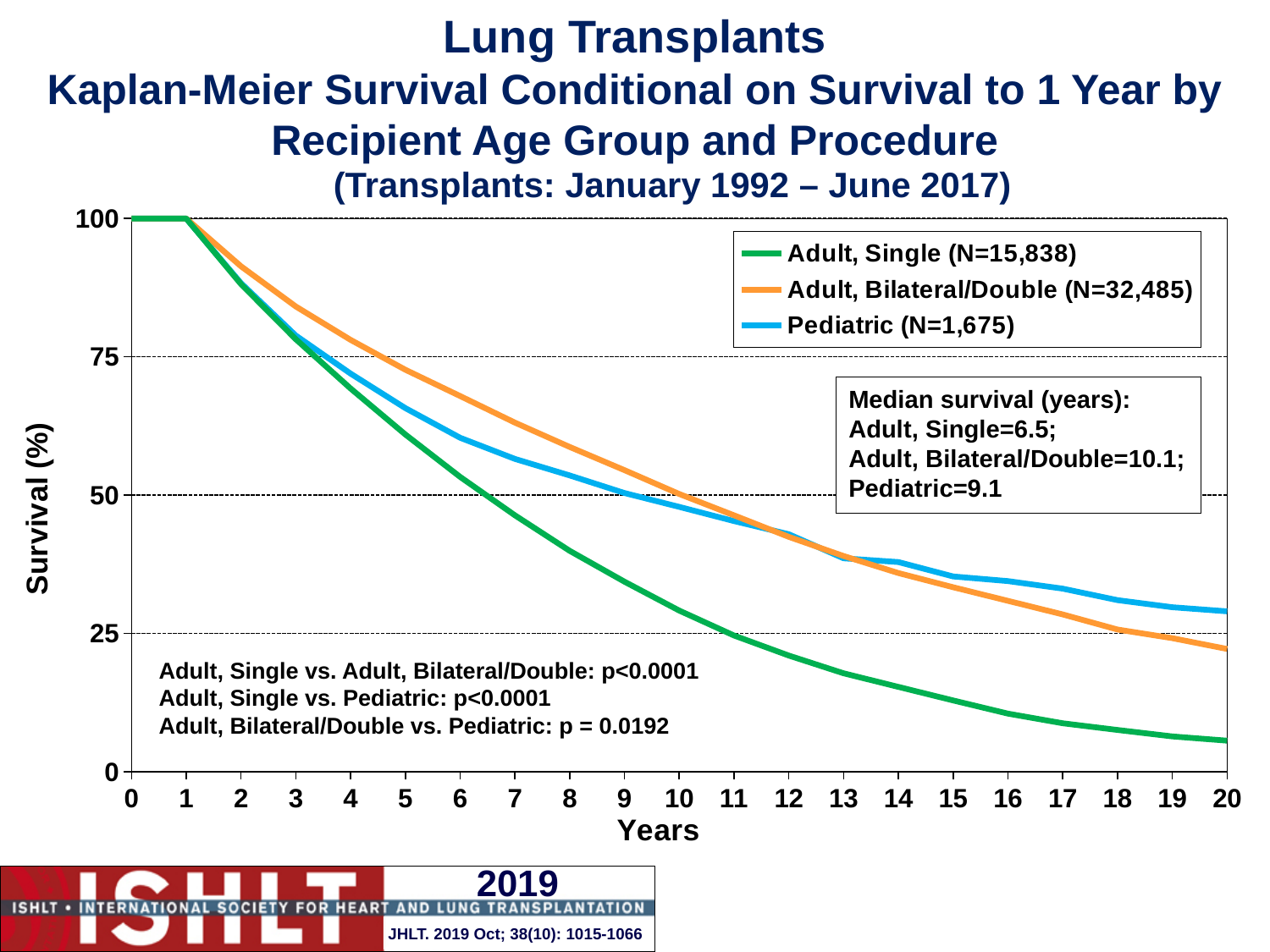
Is the survival value for Pediatric at 15 years greater or less than 25? greater Which group has the highest median survival? Adult, Bilateral/Double What is the median survival in years for the Pediatric group? 9.1 At 20 years, which curve is higher: Pediatric or Adult, Single? Pediatric How many series does the legend list? 3 What is the sample size (N) for the Pediatric group? 1,675 What is the median survival in years for the Adult, Single group? 6.5 Which group has the lowest median survival? Adult, Single What is the difference in median survival (years) between Adult, Bilateral/Double and Adult, Single? 3.6 What is the p-value for Adult, Bilateral/Double vs. Pediatric? p = 0.0192 Is the survival value for Adult, Single at 20 years greater or less than 25? less What kind of chart is shown on the slide? Line chart